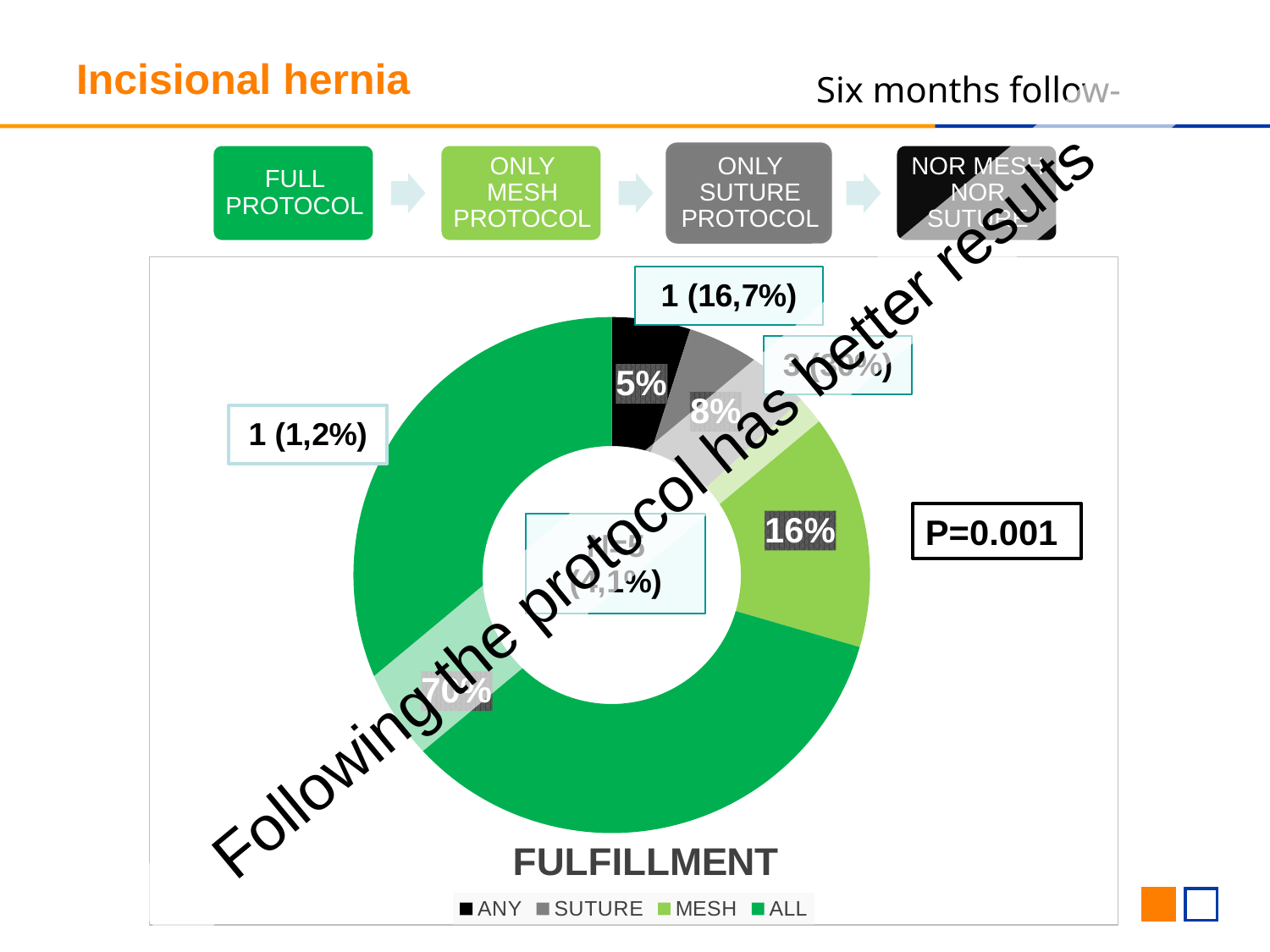
What is the difference in percentage points between the ALL slice and the MESH slice? 54 percentage points What percentage is shown for the SUTURE slice? 8% What percentage is shown for the ALL slice? 70% Which slice is larger, MESH or SUTURE? MESH What P value is printed next to the chart? P=0.001 What percentage is shown for the MESH slice? 16% What is the chart's title? FULFILLMENT Which category has the smallest slice? ANY Which category has the largest slice? ALL What kind of chart is shown on the slide? Doughnut (pie) chart How many categories does the legend list? 4 What percentage is shown for the ANY slice? 5%